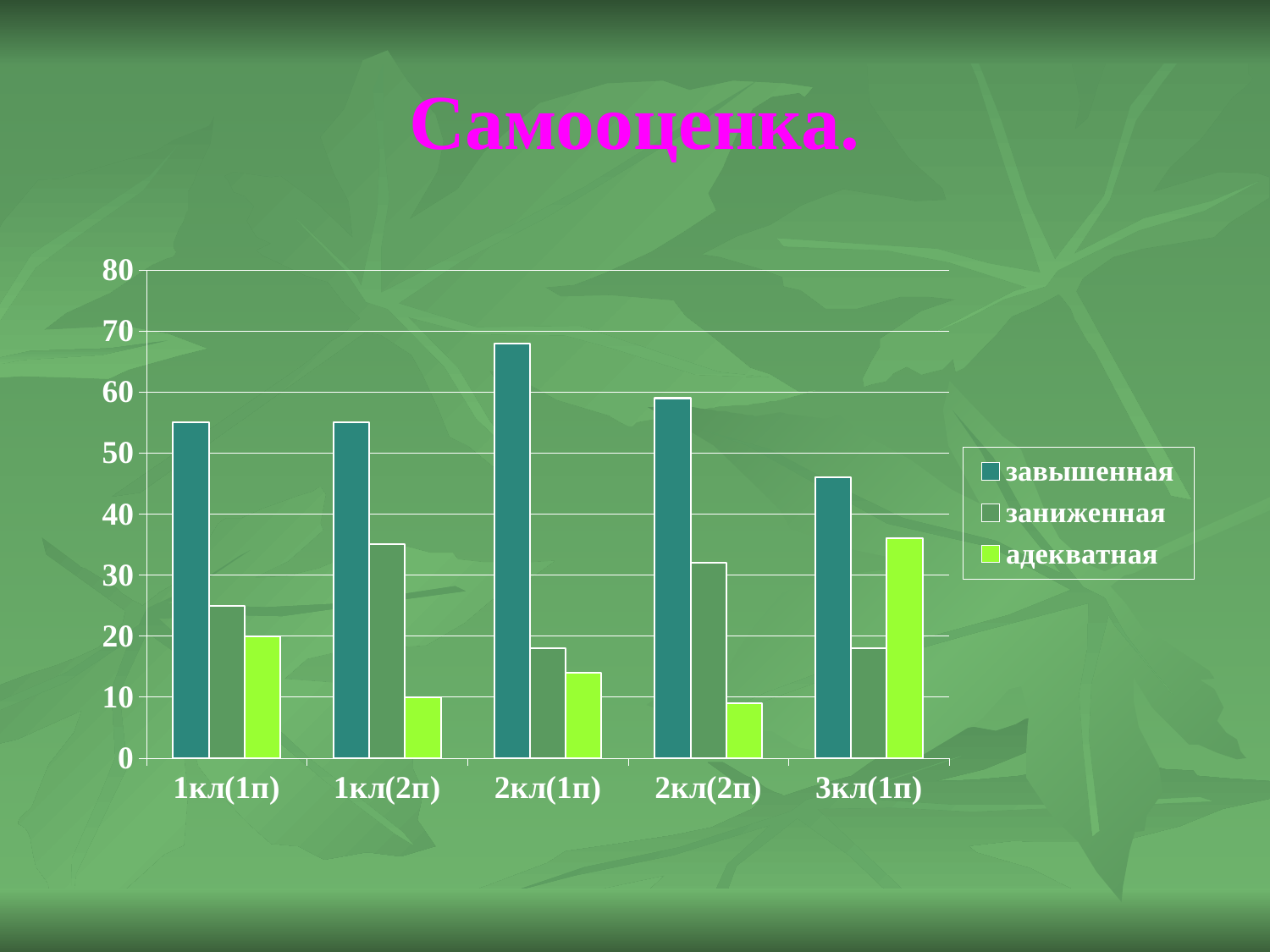
How many categories are shown on the x axis? 5 Is the value for адекватная in 3кл(1п) greater or less than 30? greater Is the value for завышенная in 3кл(1п) greater or less than 50? less Is the value for заниженная in 2кл(1п) greater or less than 20? less What kind of chart is shown on the slide? bar chart In 1кл(2п), which is larger: заниженная or адекватная? заниженная What is the title of the slide? Самооценка. Which category has the highest value for завышенная? 2кл(1п) Which category has the lowest value for завышенная? 3кл(1п) Which category has the highest value for адекватная? 3кл(1п) How many series does the legend list? 3